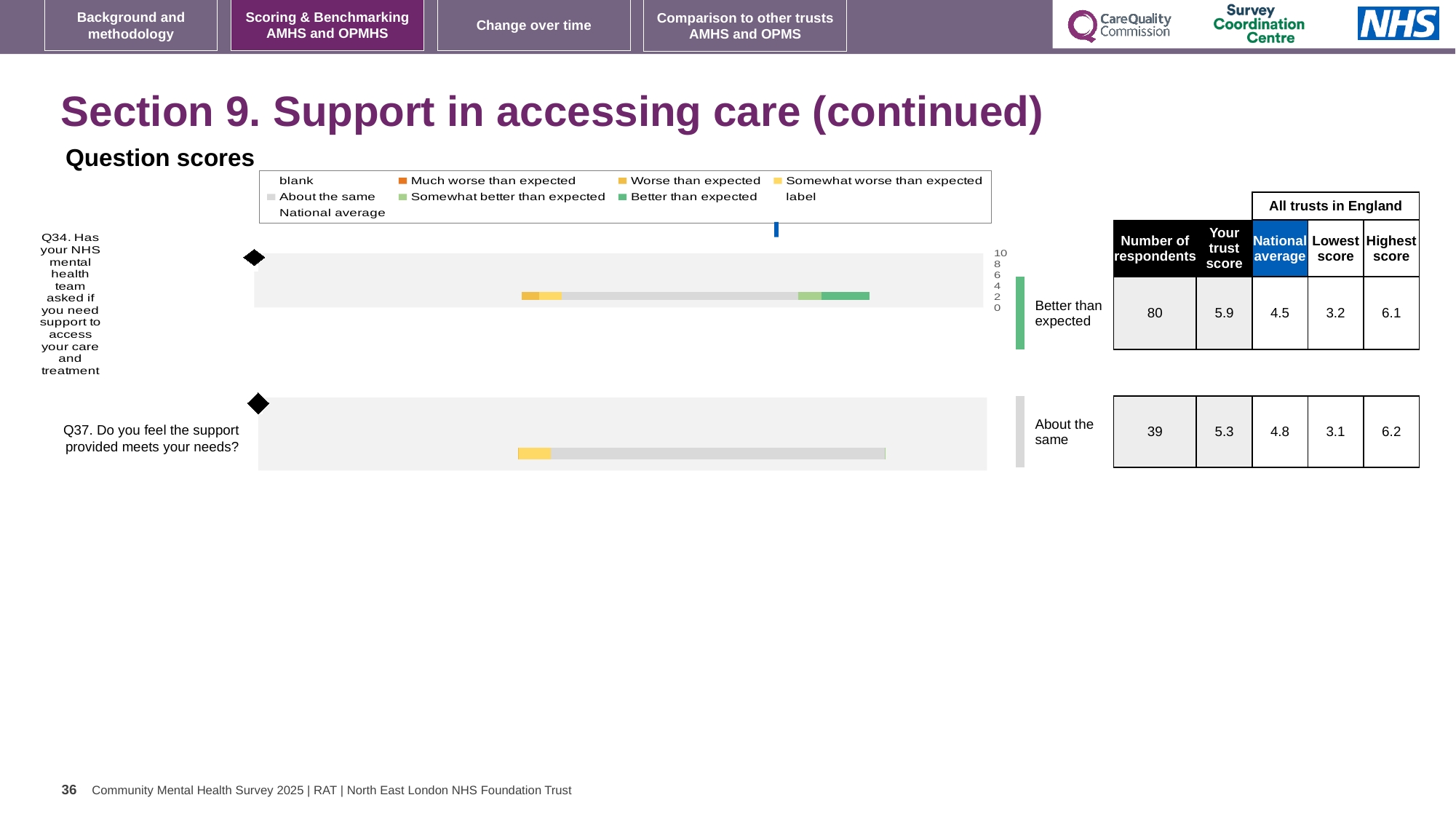
What is the highest score among all trusts in England for Q37? 6.2 Which question has the higher trust score, Q34 or Q37? Q34 By how much does the trust score for Q34 exceed the national average for Q34? 1.4 What is the difference between the highest and lowest scores for Q37 across all trusts in England? 3.1 How many survey questions are plotted in the question scores chart? 2 What is the national average score for Q34? 4.5 How many respondents answered Q37? 39 What is the trust score for Q37 (Do you feel the support provided meets your needs)? 5.3 What kind of chart is used to show the question scores on this slide? bar chart What is the trust score for Q34 (Has your NHS mental health team asked if you need support to access your care and treatment)? 5.9 What benchmark label is shown next to the bar for Q37? About the same What benchmark label is shown next to the bar for Q34? Better than expected